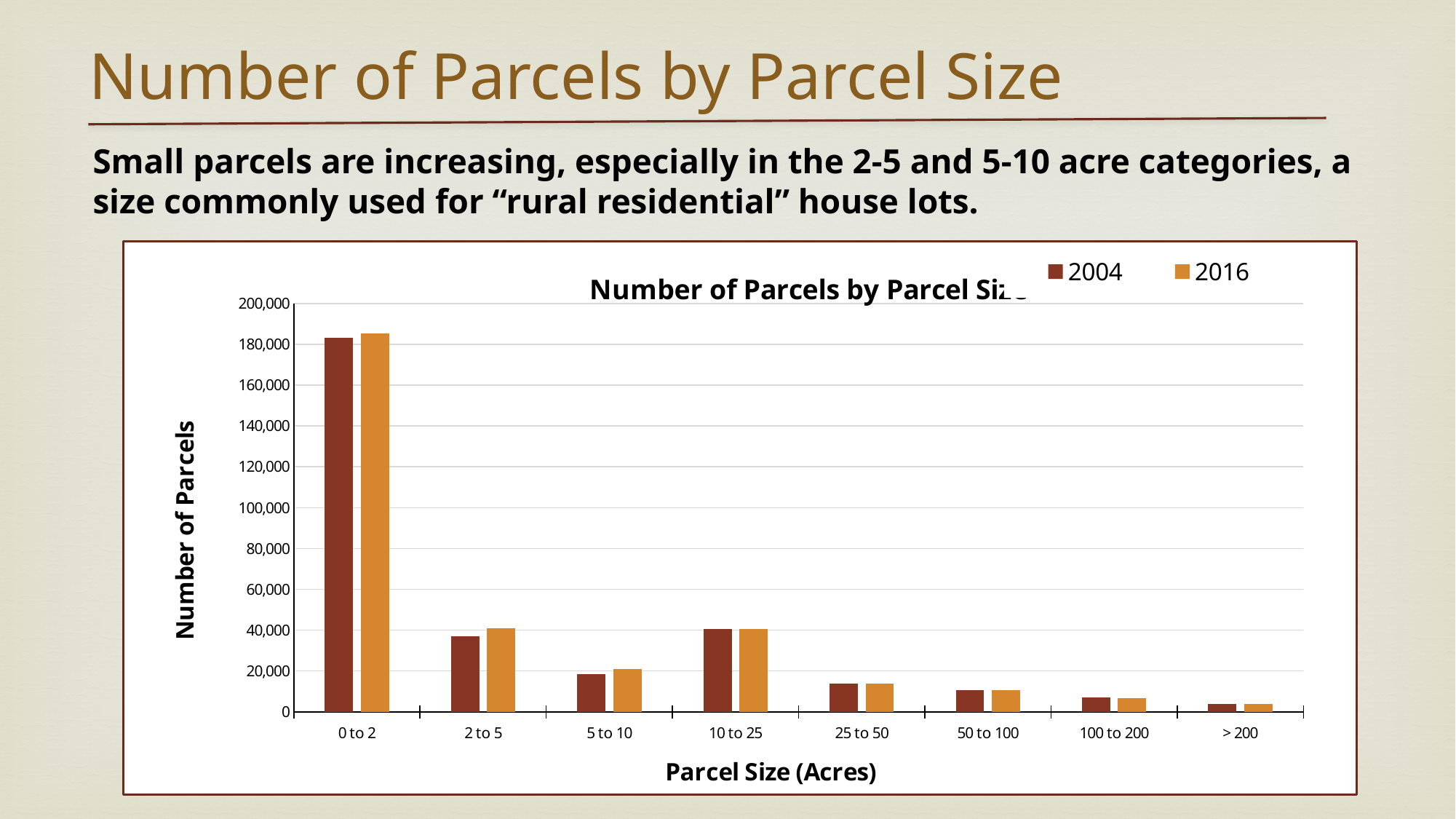
Is the 2004 value for the 0 to 2 acre category greater or less than 160,000? greater Is the 2016 value for the 2 to 5 acre category greater or less than 60,000? less What kind of chart is shown on the slide? bar chart In the 5 to 10 acre category, which year has the larger number of parcels, 2004 or 2016? 2016 How many parcel size categories are shown on the x axis of the chart? 8 What is the title of the x axis of the chart? Parcel Size (Acres) Is the 2016 value for the 10 to 25 acre category greater or less than 20,000? greater Which colour represents the 2016 series in the chart? orange In the 2 to 5 acre category, which year has the larger number of parcels, 2004 or 2016? 2016 Which parcel size category has the lowest number of parcels for 2004? > 200 How many series does the legend list in the chart? 2 Which parcel size category has the highest number of parcels for 2016? 0 to 2